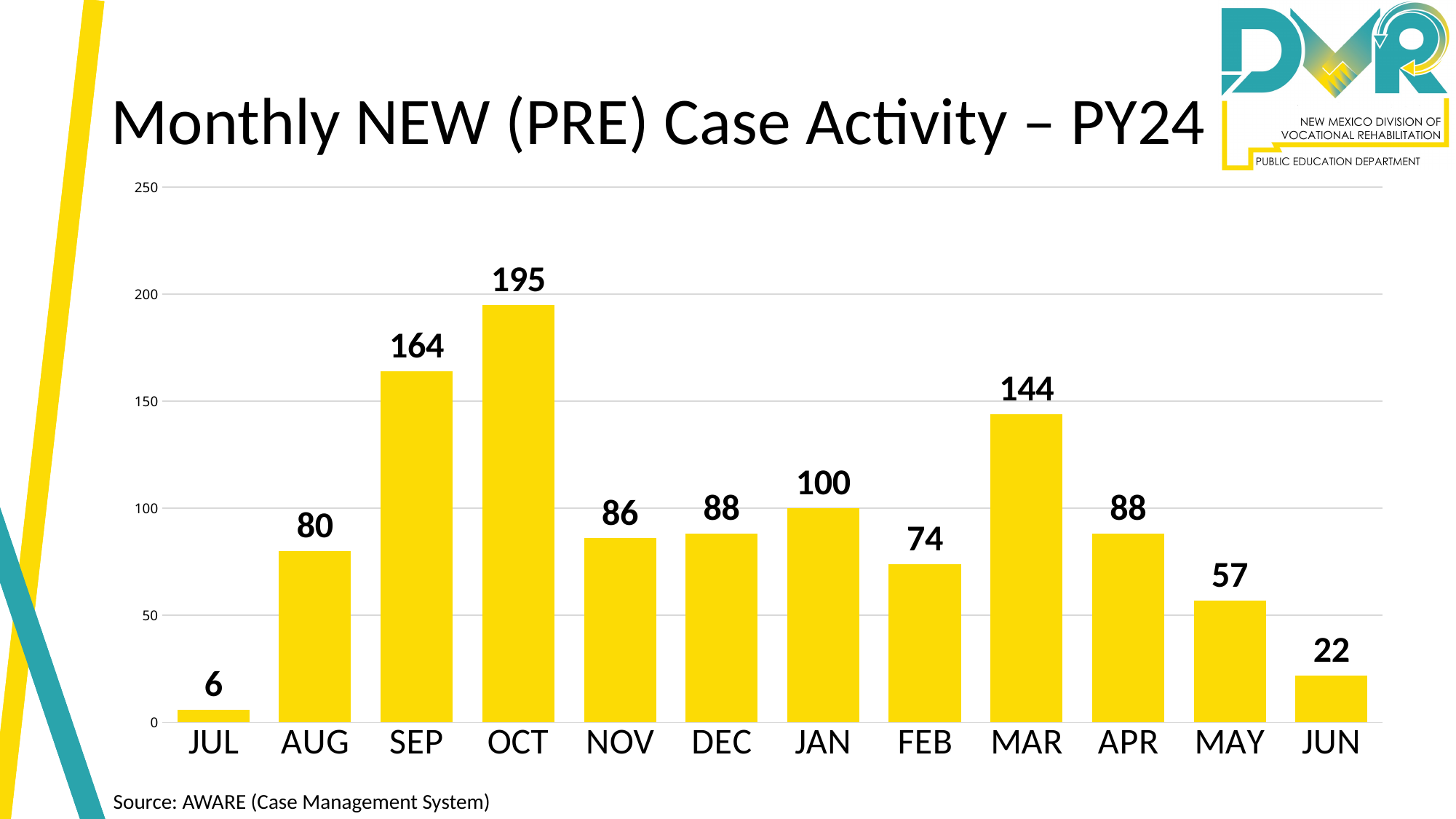
What kind of chart is shown on the slide? bar chart How many months are shown on the x axis? 12 Which month has the highest value? OCT What is the difference between the values for OCT and SEP? 31 Which is larger, the value for NOV or the value for FEB? NOV Is the value for MAY greater or less than 50? greater What is the value for JUL? 6 What is the value for OCT? 195 What is the value for MAR? 144 Do the values rise or fall from MAR to JUN? fall What is the title of the chart? Monthly NEW (PRE) Case Activity – PY24 Which month has the lowest value? JUL